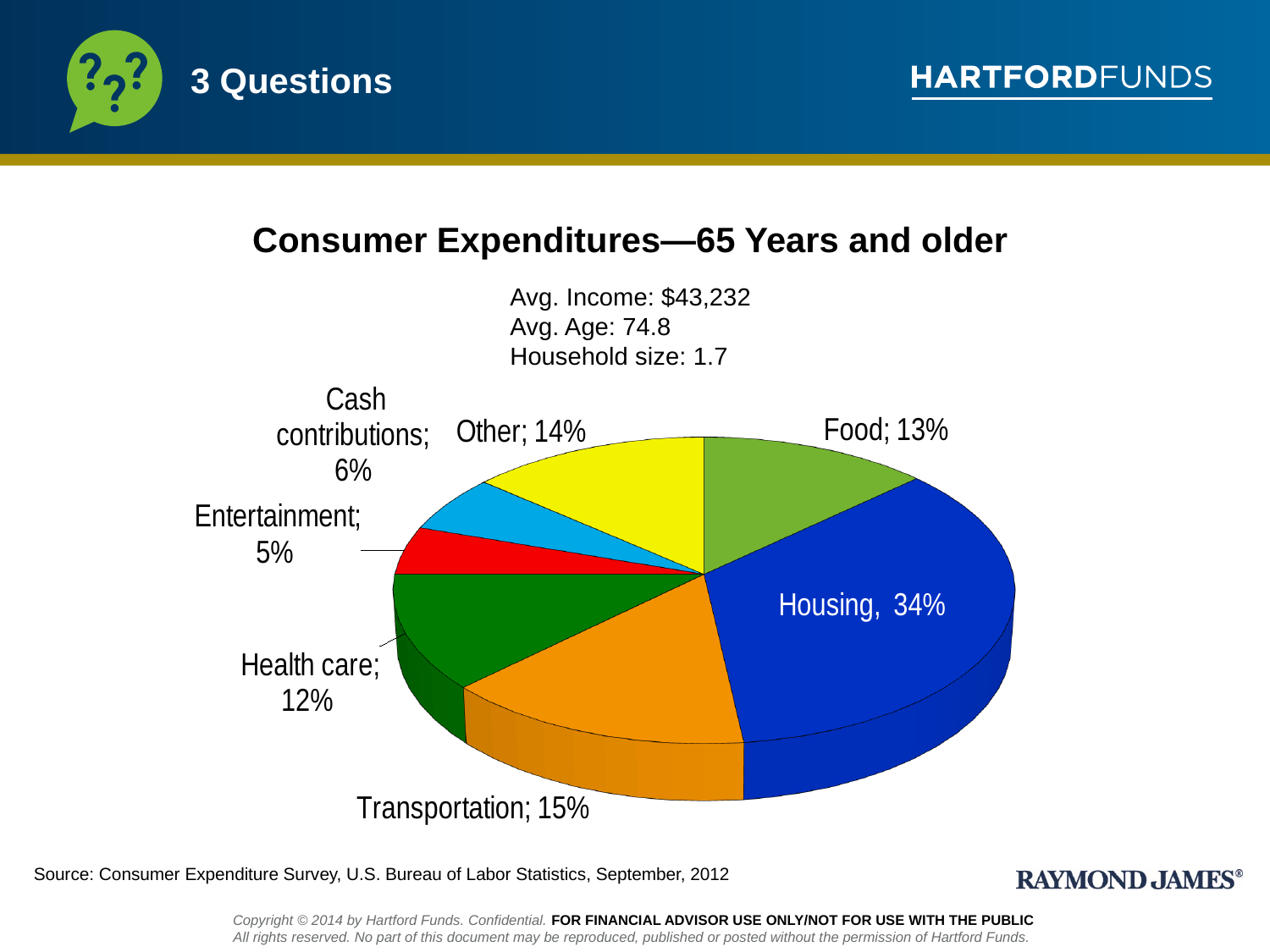
What is the title of the chart? Consumer Expenditures—65 Years and older What share of consumer expenditures goes to Transportation? 15% How many categories are shown in the pie chart? 7 What share of consumer expenditures goes to Cash contributions? 6% What is the difference between the Housing share and the Transportation share? 19% What share of consumer expenditures goes to Housing? 34% What share of consumer expenditures goes to Health care? 12% Which category has the largest share of expenditures? Housing What colour is the Housing slice? Blue What kind of chart is shown on the slide? Pie chart Which is larger, the share for Food or the share for Other? Other Which category has the smallest share of expenditures? Entertainment